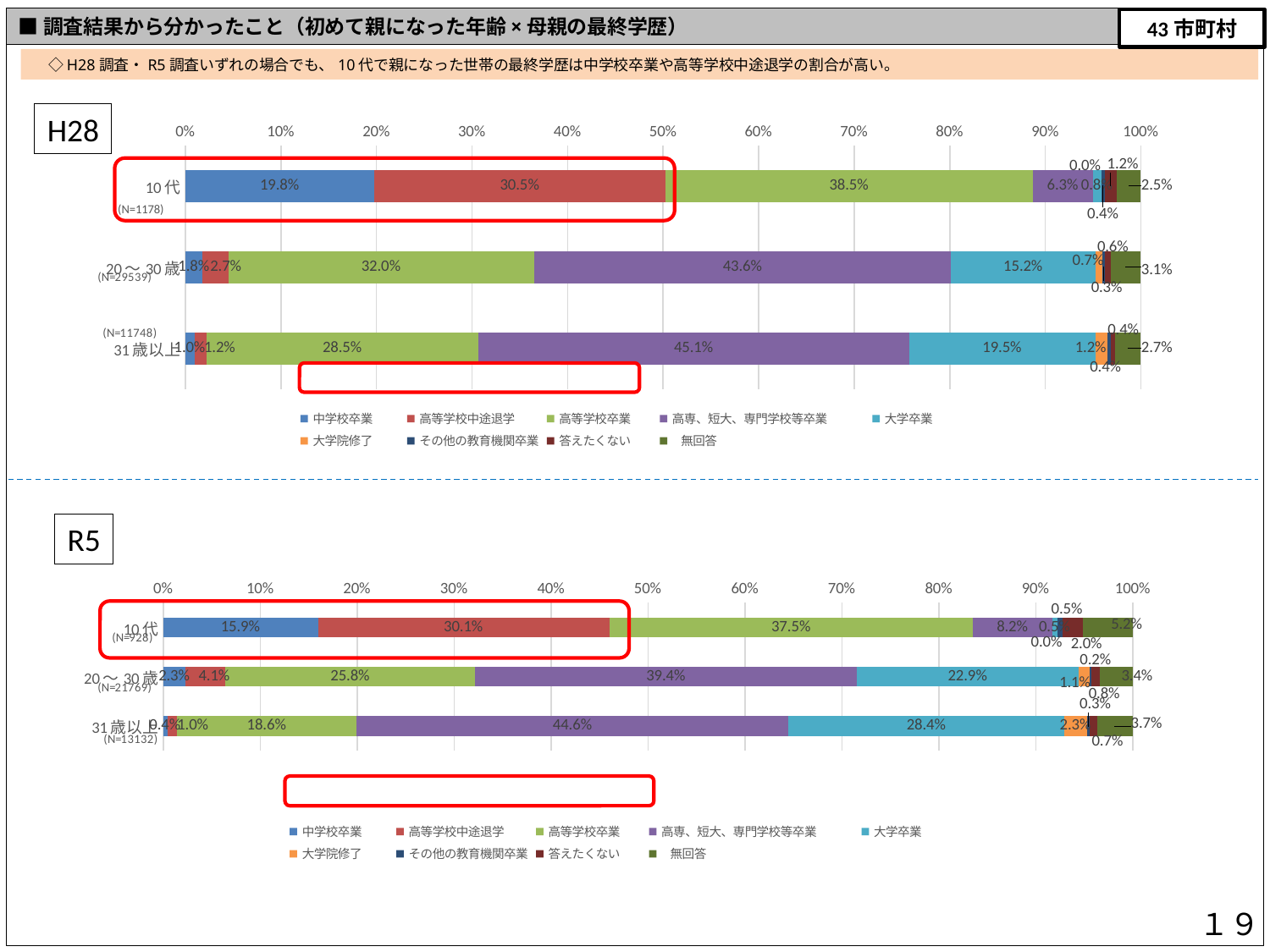
In the H28 chart, which category has the highest value for 大学卒業? 31歳以上 In the R5 chart, which category has the lowest value for 高等学校卒業? 31歳以上 In the H28 chart, what is the difference between the 高等学校卒業 values for 10代 and 20～30歳? 6.5% In the H28 chart, what is the value for 高専、短大、専門学校等卒業 in the 31歳以上 category? 45.1% In the R5 chart, what is the sample size (N) shown for the 10代 category? N=928 How many age categories are shown in the H28 chart? 3 In the R5 chart, what is the value for 大学卒業 in the 31歳以上 category? 28.4% How many series does the legend of the R5 chart list? 9 In the R5 chart, what is the value for 高等学校中途退学 in the 10代 category? 30.1% In the R5 chart, which is larger for 20～30歳: 高専、短大、専門学校等卒業 or 大学卒業? 高専、短大、専門学校等卒業 What kind of chart is the H28 chart? Stacked bar chart In the H28 chart, what is the value for 中学校卒業 in the 10代 category? 19.8%